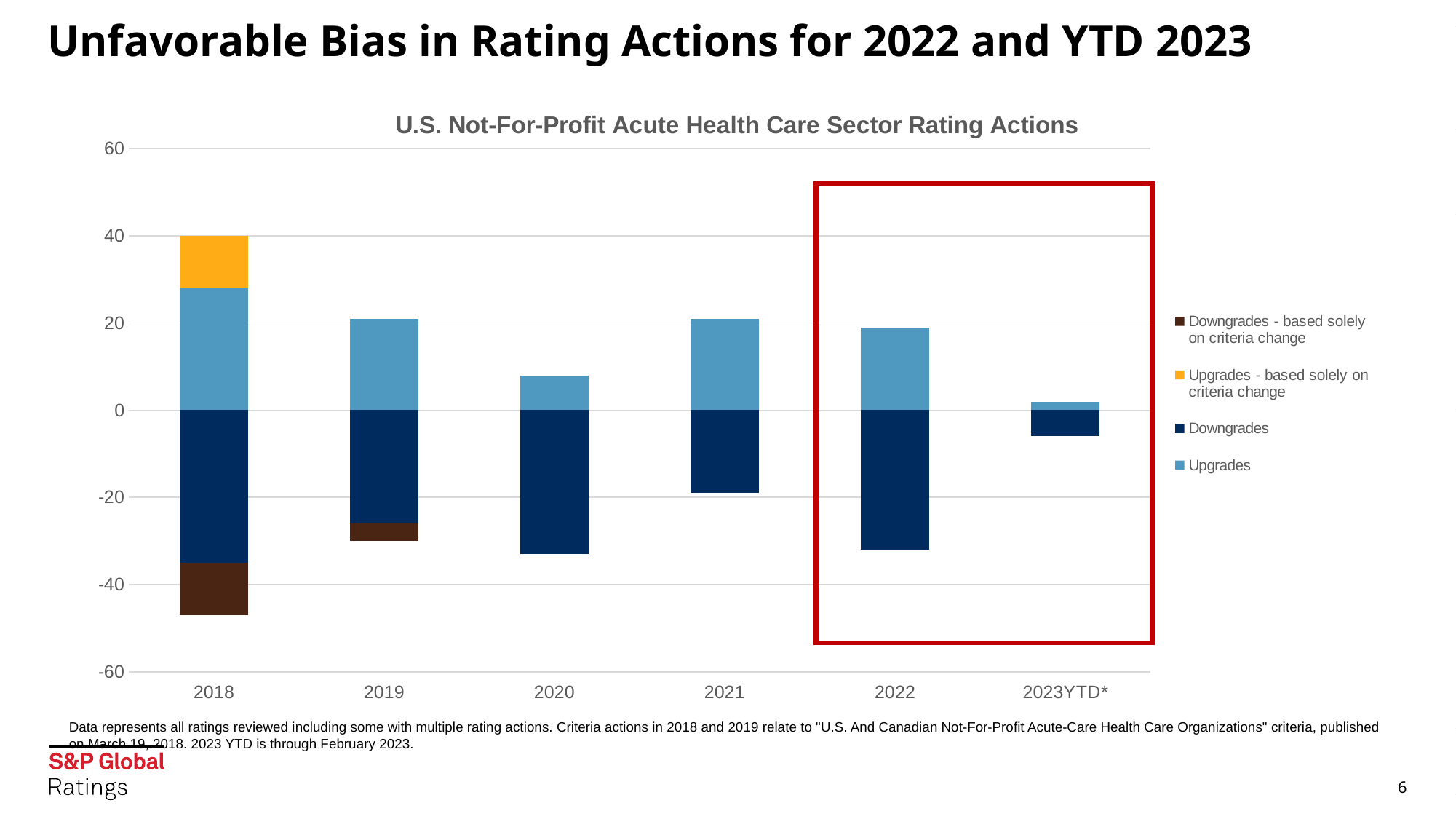
Which year has the larger Upgrades bar, 2019 or 2020? 2019 Is the Downgrades value for 2023YTD* greater or less than -20? greater What is the title of the chart? U.S. Not-For-Profit Acute Health Care Sector Rating Actions How many series does the chart legend list? 4 Is the Downgrades value for 2020 greater or less than -20? less Which years are enclosed by the red box on the chart? 2022 and 2023YTD* What kind of chart is shown on the slide? Stacked bar chart Is the Upgrades value for 2020 greater or less than 20? less Which year has the smallest Upgrades bar? 2023YTD* Which year has the tallest Upgrades bar? 2018 How many years (categories) are shown on the x axis of the chart? 6